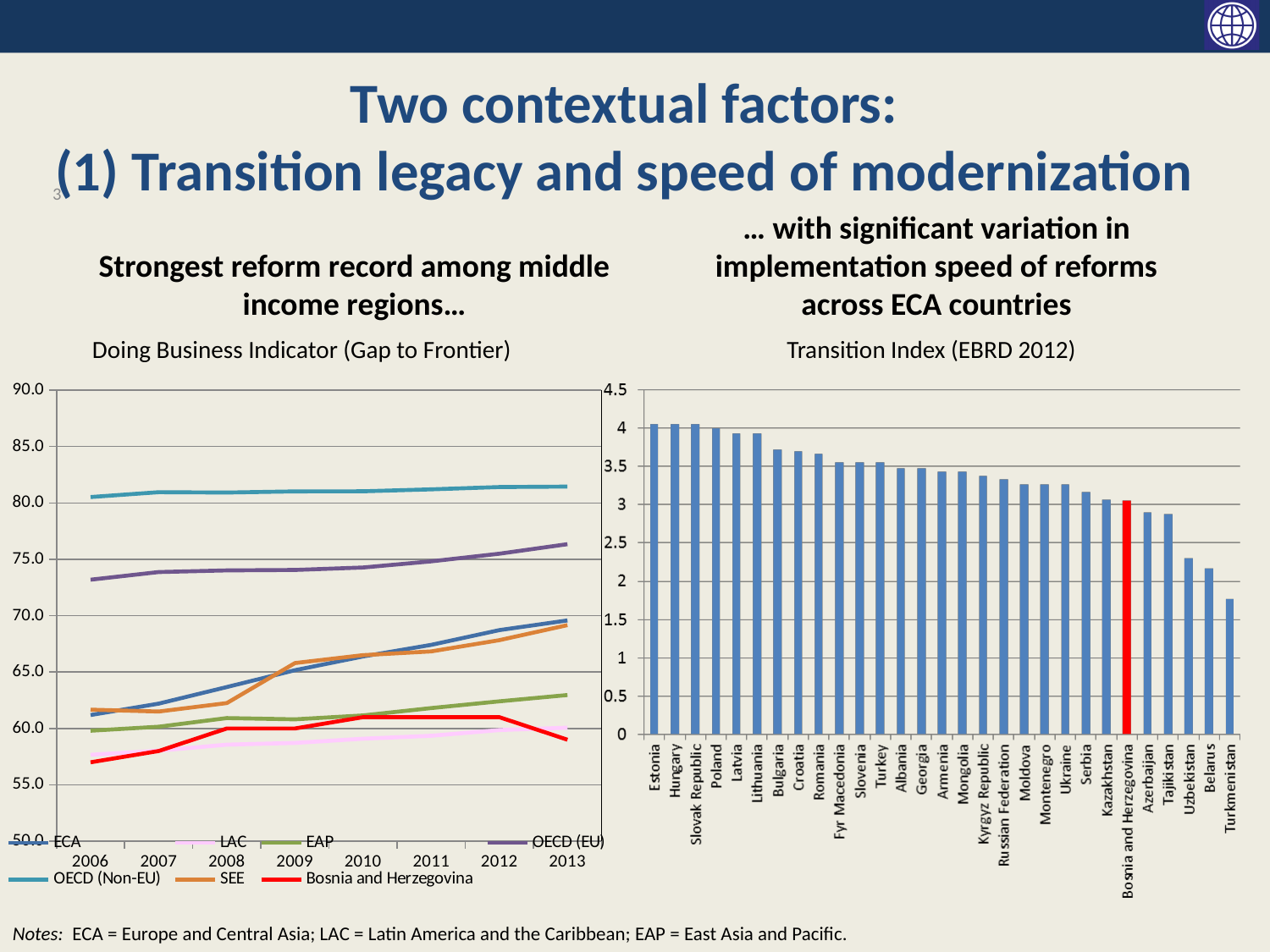
In the Transition Index (EBRD 2012) chart, which bar is coloured red? Bosnia and Herzegovina How many series does the legend of the Doing Business Indicator (Gap to Frontier) chart list? 7 What kind of chart is the Transition Index (EBRD 2012) chart on the right? bar chart In the Doing Business Indicator (Gap to Frontier) chart, does the ECA series rise or fall from 2006 to 2013? rise What kind of chart is the Doing Business Indicator (Gap to Frontier) chart on the left? line chart In the Transition Index (EBRD 2012) chart, which is larger, the value for Bosnia and Herzegovina or the value for Azerbaijan? Bosnia and Herzegovina In the Doing Business Indicator (Gap to Frontier) chart, which series has the highest values across all years? OECD (Non-EU) In the Transition Index (EBRD 2012) chart, which country has the lowest value? Turkmenistan In the Transition Index (EBRD 2012) chart, is the value for Turkmenistan greater or less than 2? less How many countries are shown in the Transition Index (EBRD 2012) chart? 29 In the Transition Index (EBRD 2012) chart, is the value for Poland greater or less than 3.5? greater